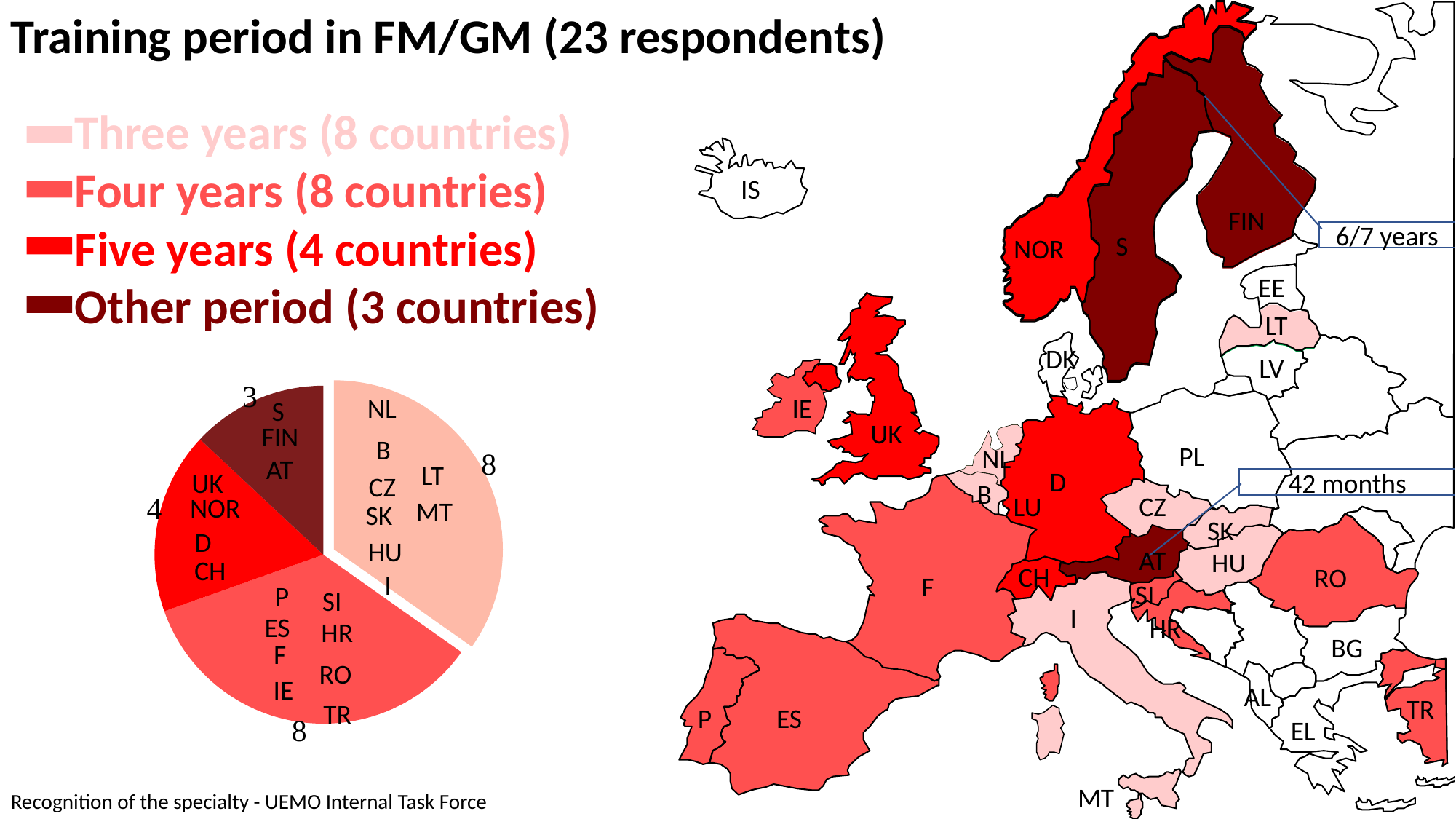
What is the difference between the number of countries with a five-year training period and those with another period? 1 How many countries are in the 'Three years' slice of the pie chart? 8 Which has more countries: 'Four years' or 'Five years'? Four years How many countries are in the 'Five years' slice of the pie chart? 4 Which legend entry is shown in the darkest red colour? Other period (3 countries) What is the title of the slide's chart? Training period in FM/GM (23 respondents) What is the total number of countries across all slices of the pie chart? 23 Which category has the fewest countries in the pie chart? Other period How many countries are in the 'Other period' slice of the pie chart? 3 How many slices does the pie chart have? 4 How many entries does the legend list? 4 What kind of chart is shown on the slide? pie chart